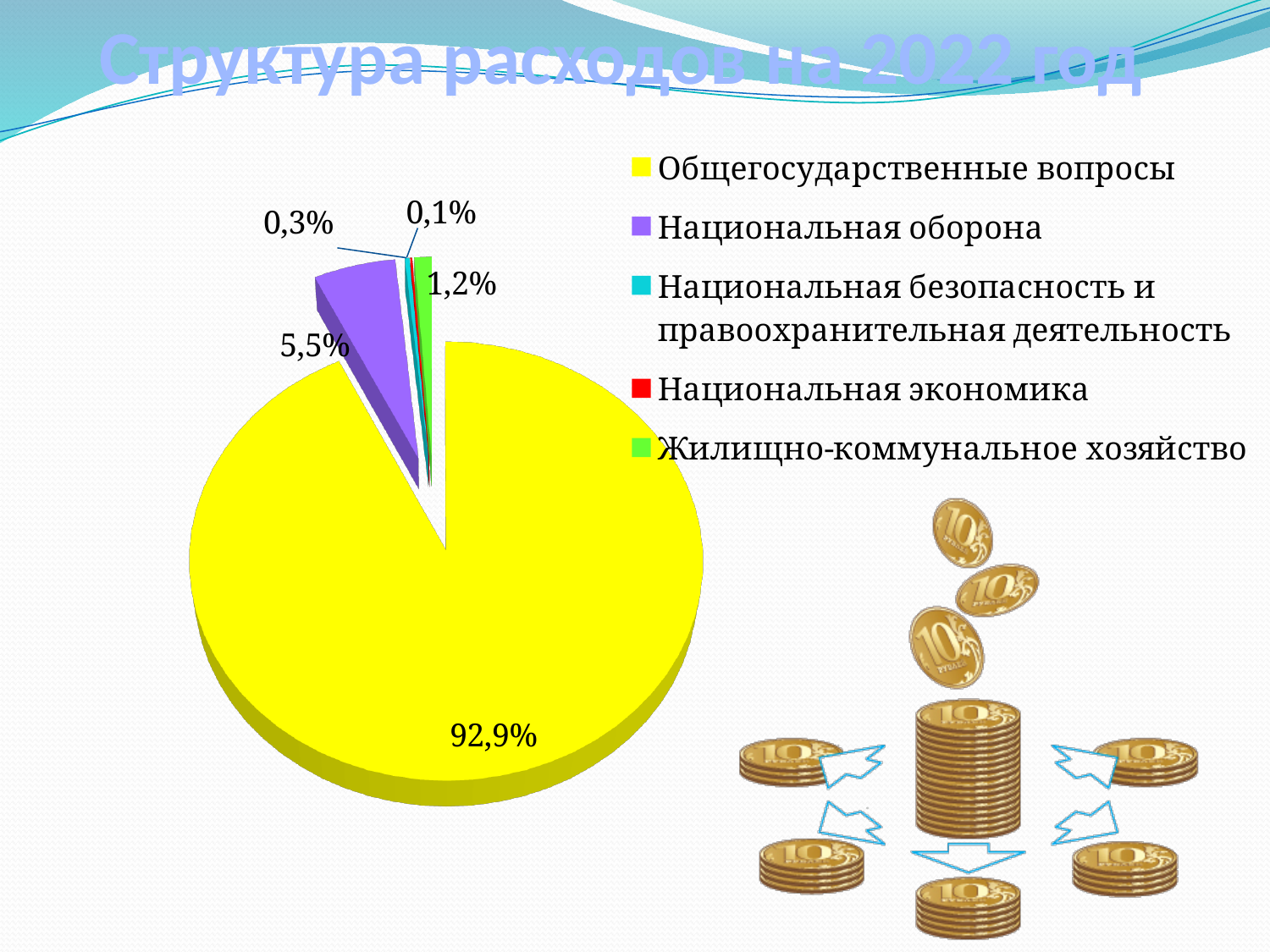
Which category has the smallest share of the pie? Национальная экономика What is the title of the chart on the slide? Структура расходов на 2022 год Which is larger, the share for Национальная оборона or the share for Жилищно-коммунальное хозяйство? Национальная оборона What is the difference between the share for Национальная оборона and the share for Жилищно-коммунальное хозяйство? 4,3% What kind of chart is shown on the slide? pie chart What is the value shown for Жилищно-коммунальное хозяйство? 1,2% Which category has the largest share of the pie? Общегосударственные вопросы How many categories does the legend of the pie chart list? 5 What share of the pie does Общегосударственные вопросы take? 92,9% What is the value shown for Национальная оборона? 5,5% What is the value shown for Национальная безопасность и правоохранительная деятельность? 0,3% What is the value shown for Национальная экономика? 0,1%